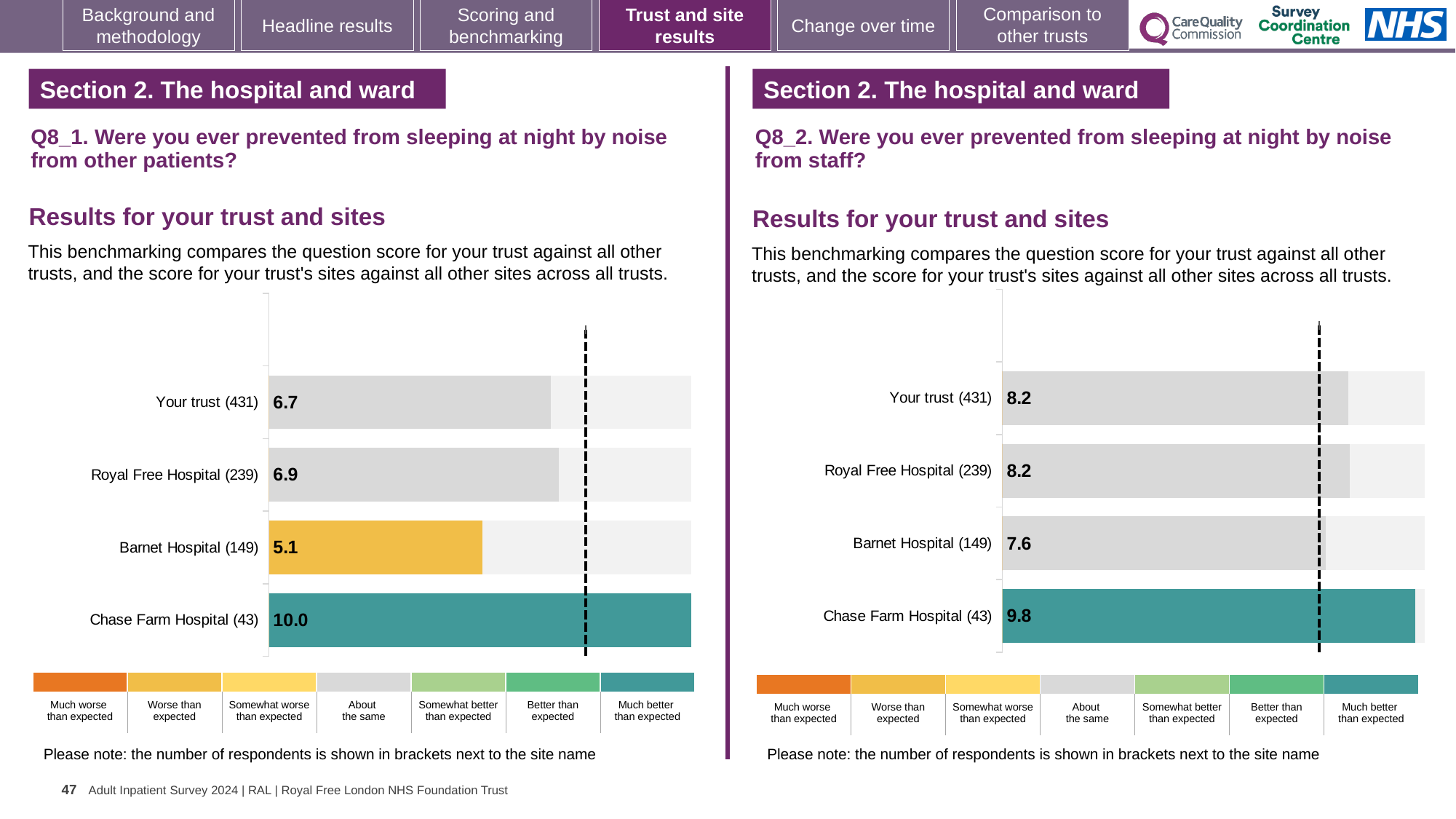
In the Q8_1 chart (left), which site has the highest score? Chase Farm Hospital (43) In the Q8_2 chart (right), is the score for Royal Free Hospital (239) larger or smaller than the score for Chase Farm Hospital (43)? smaller In the Q8_1 chart (left), which site has the lowest score? Barnet Hospital (149) What kind of chart is used on the left side of the slide for Q8_1? bar chart In the Q8_1 chart (left), how many bars are plotted? 4 In the Q8_2 chart (right), what is the score for Barnet Hospital (149)? 7.6 In the Q8_2 chart (right), what is the score for Chase Farm Hospital (43)? 9.8 In the Q8_1 chart (left), what is the score for Barnet Hospital (149)? 5.1 In the Q8_1 chart (left), what is the difference between the scores for Chase Farm Hospital (43) and Barnet Hospital (149)? 4.9 In the Q8_2 chart (right), what is the difference between the scores for Your trust (431) and Barnet Hospital (149)? 0.6 In the Q8_1 chart (left), what is the score for Your trust (431)? 6.7 In the Q8_2 chart (right), which site has the lowest score? Barnet Hospital (149)